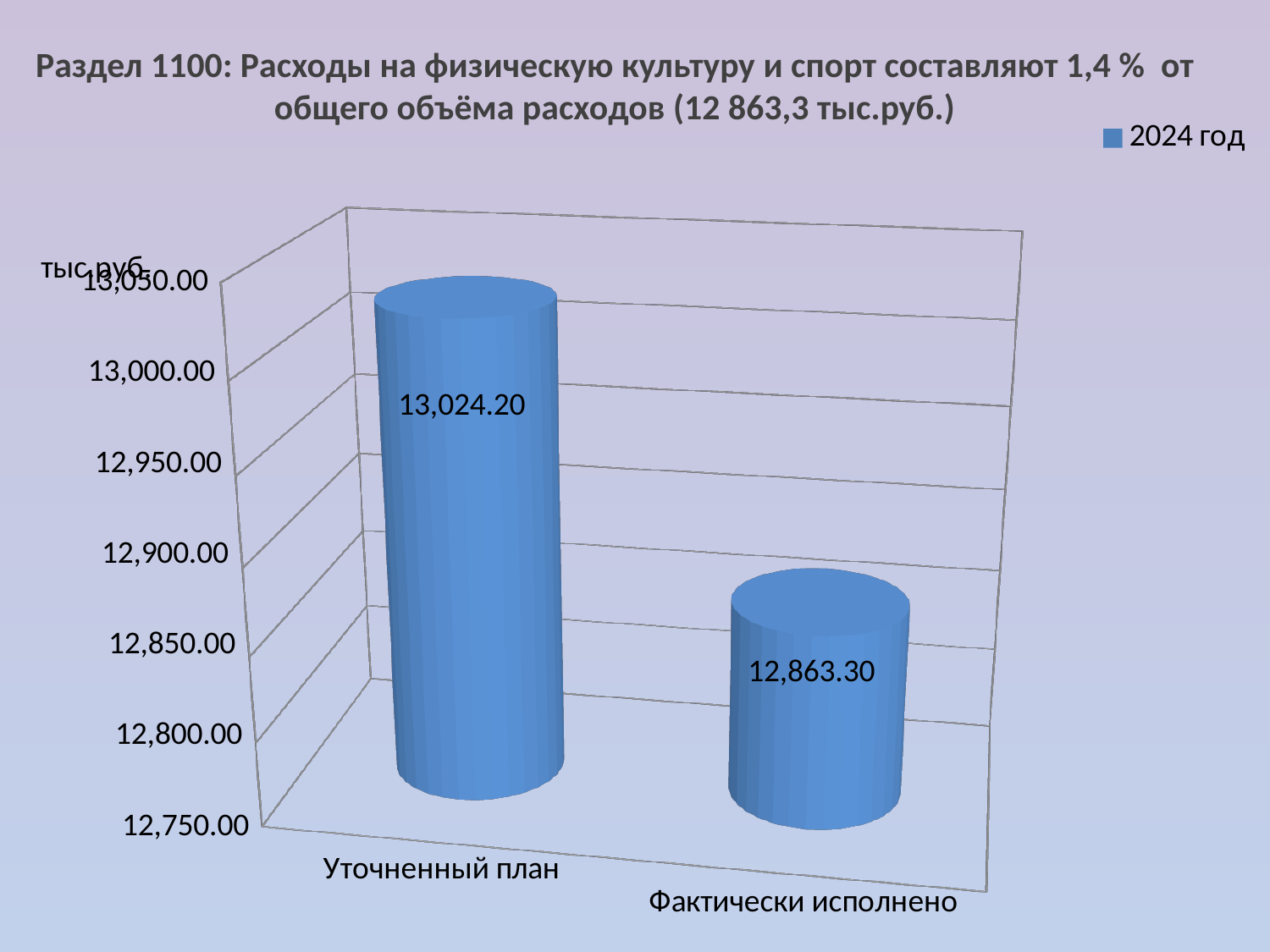
Is the value for "Фактически исполнено" greater or less than 12,900.00? less What series name is shown in the legend? 2024 год How many categories are shown on the chart? 2 Which category has the highest value? Уточненный план What is the value for "Фактически исполнено"? 12,863.30 Is the value for "Уточненный план" greater or less than 13,000.00? greater Which is larger: the value for "Уточненный план" or for "Фактически исполнено"? Уточненный план How many series does the legend list? 1 What is the difference between the values for "Уточненный план" and "Фактически исполнено"? 160.90 What kind of chart is shown on the slide? bar chart What is the value for "Уточненный план"? 13,024.20 Which category has the lowest value? Фактически исполнено